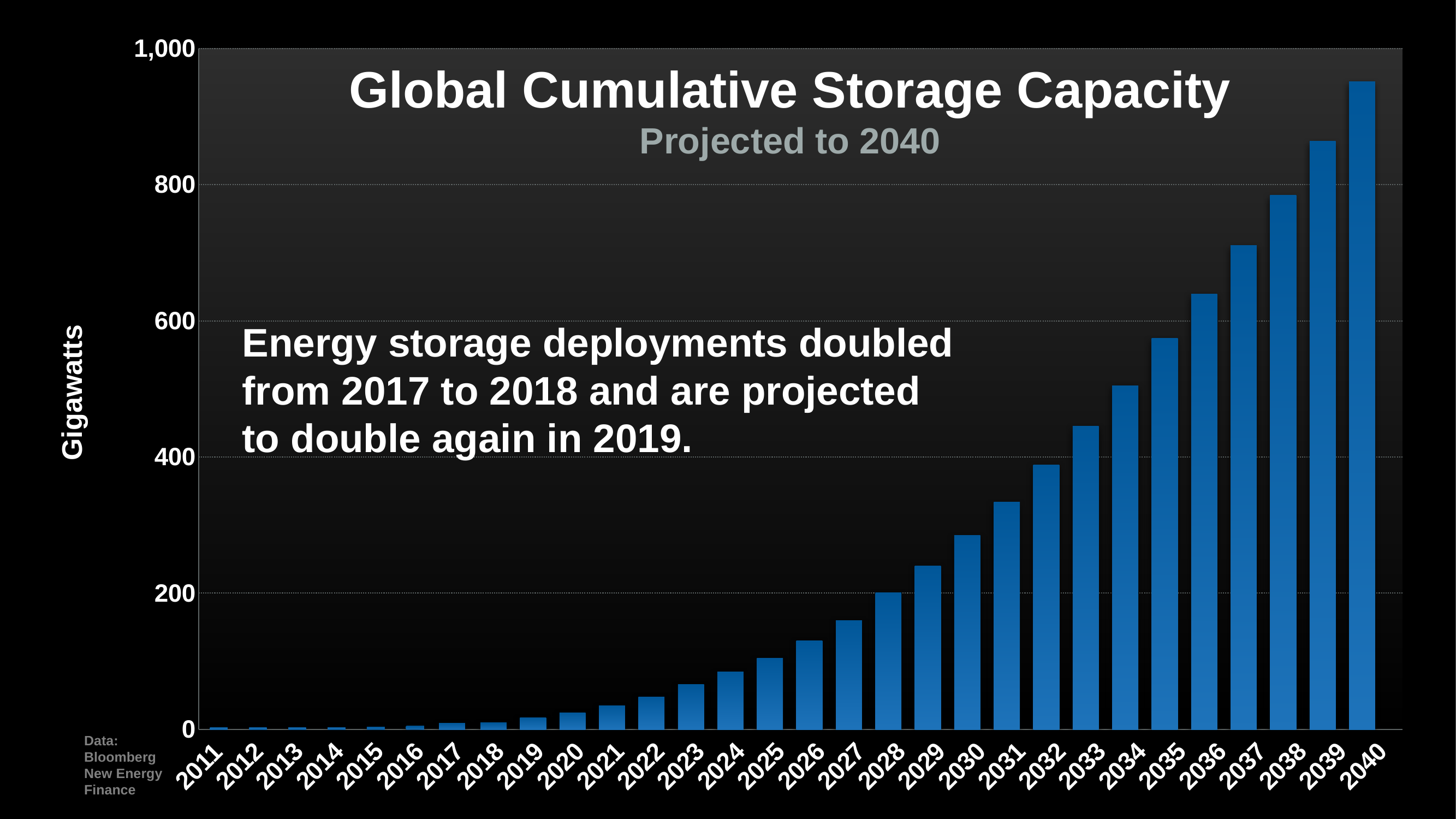
What unit is shown on the y axis label? Gigawatts Is the value for 2031 greater or less than 400? less Which year has the lowest global cumulative storage capacity? 2011 What kind of chart is shown on the slide? bar chart Which is larger, the value for 2035 or the value for 2025? 2035 How many years are plotted on the x axis? 30 Is the value for 2038 greater or less than 800? less Is the value for 2037 greater or less than 600? greater Which year has the highest global cumulative storage capacity? 2040 Do the values rise or fall from 2011 to 2040? rise